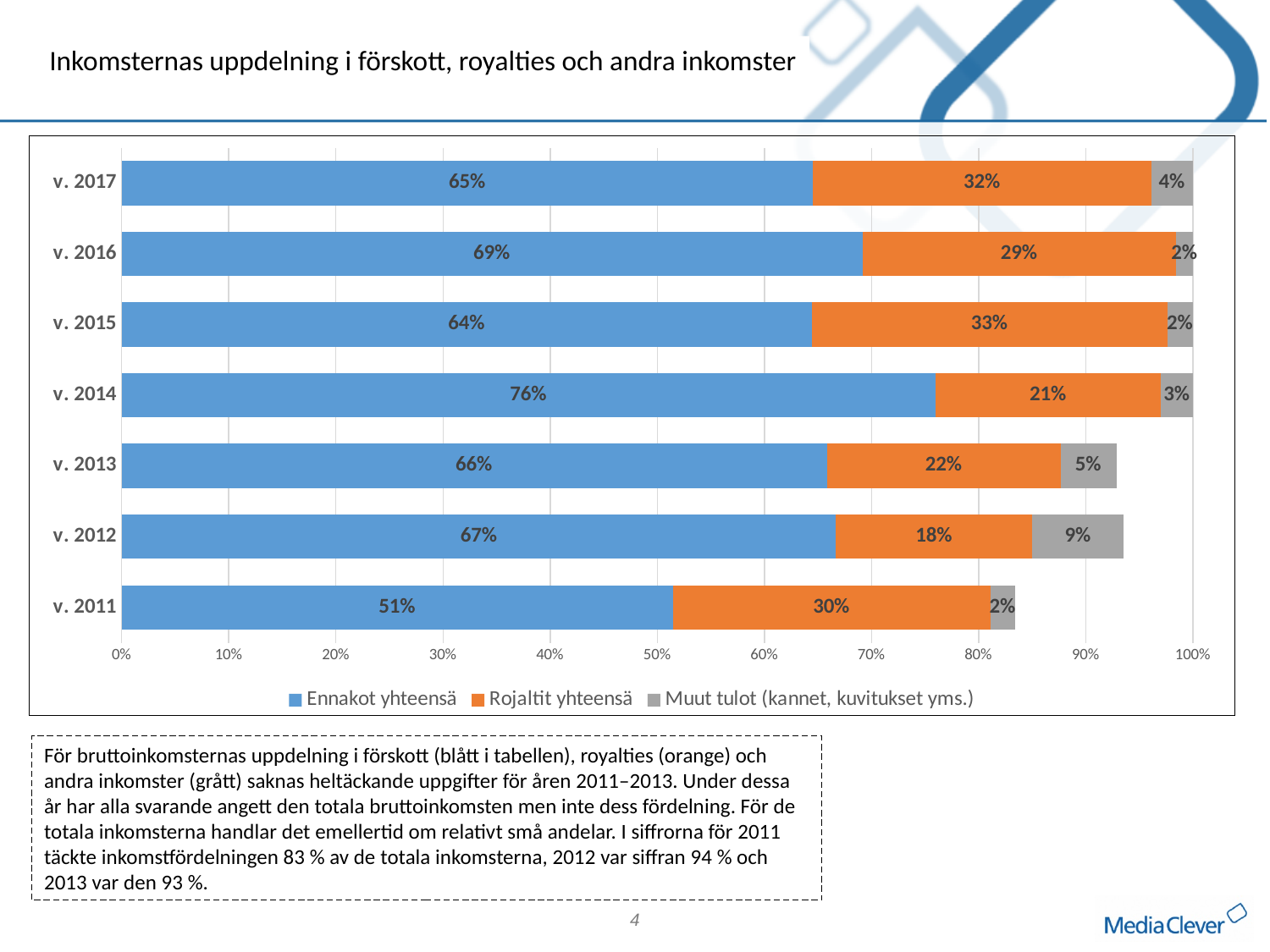
Which year has the highest value for Rojaltit yhteensä? v. 2015 What is the total of the stacked bar for v. 2012? 94% How many series does the legend list? 3 What kind of chart is shown on the slide? Stacked bar chart Which year has the highest value for Ennakot yhteensä? v. 2014 What is the value of Muut tulot (kannet, kuvitukset yms.) for v. 2012? 9% Which year has the lowest value for Ennakot yhteensä? v. 2011 What is the value of Ennakot yhteensä for v. 2014? 76% What is the value of Rojaltit yhteensä for v. 2017? 32% What is the difference between the Ennakot yhteensä values for v. 2014 and v. 2011? 25% Which is larger, Rojaltit yhteensä for v. 2016 or for v. 2013? v. 2016 How many years are shown on the chart? 7